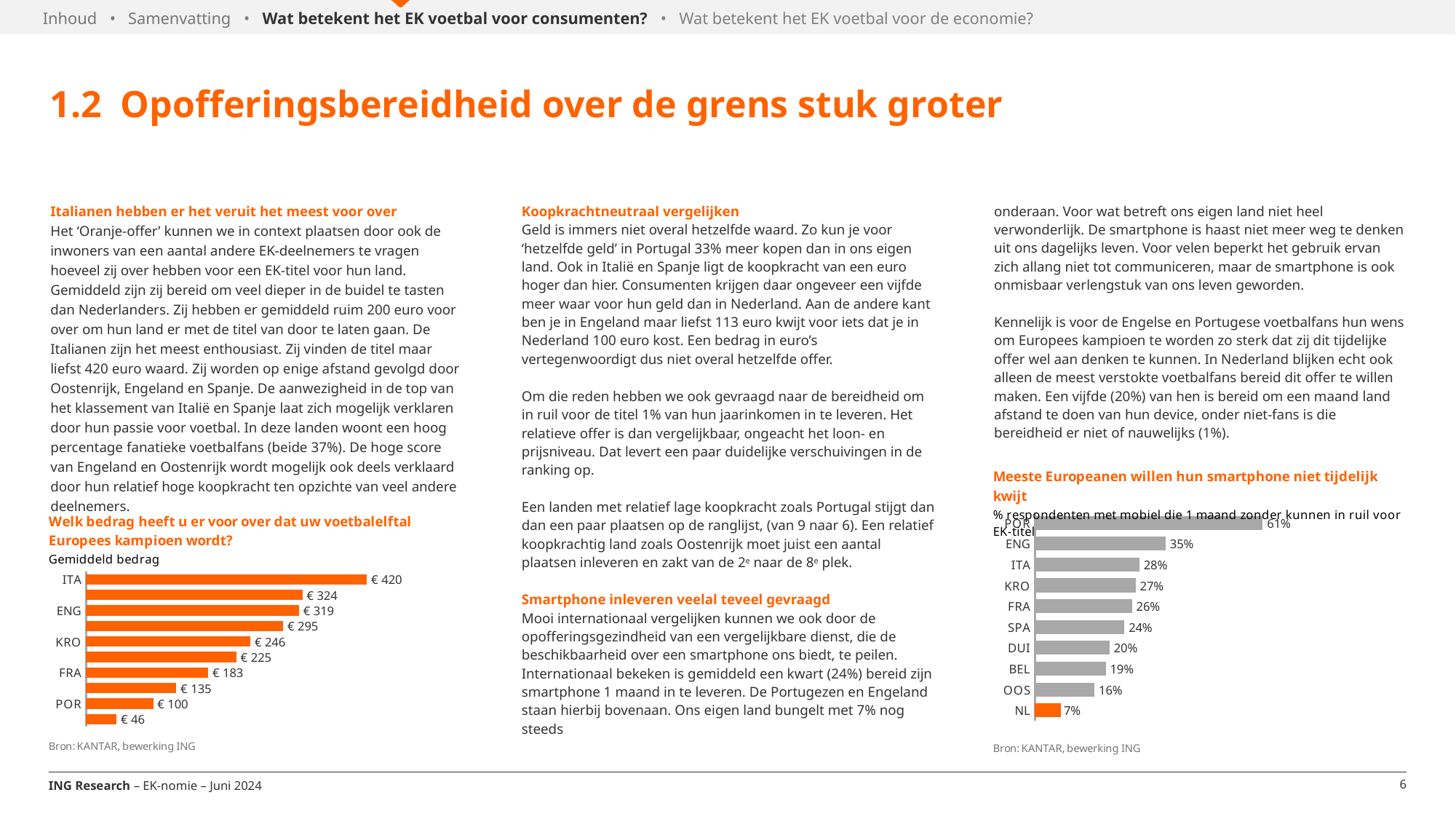
In the chart 'Welk bedrag heeft u er voor over dat uw voetbalelftal Europees kampioen wordt?', what is the value for ITA? € 420 What kind of chart is 'Welk bedrag heeft u er voor over dat uw voetbalelftal Europees kampioen wordt?'? Bar chart In the chart 'Meeste Europeanen willen hun smartphone niet tijdelijk kwijt', what is the value for POR? 61% In the chart 'Welk bedrag heeft u er voor over dat uw voetbalelftal Europees kampioen wordt?', what is the difference between the values for ENG and FRA? € 136 In the chart 'Welk bedrag heeft u er voor over dat uw voetbalelftal Europees kampioen wordt?', which labelled country has the highest value? ITA In the chart 'Meeste Europeanen willen hun smartphone niet tijdelijk kwijt', what is the value for NL? 7% In the chart 'Welk bedrag heeft u er voor over dat uw voetbalelftal Europees kampioen wordt?', what is the value for POR? € 100 In the chart 'Meeste Europeanen willen hun smartphone niet tijdelijk kwijt', which is larger, the value for DUI or the value for OOS? DUI In the chart 'Meeste Europeanen willen hun smartphone niet tijdelijk kwijt', what is the difference between the values for POR and ENG? 26% In the chart 'Meeste Europeanen willen hun smartphone niet tijdelijk kwijt', which bar is coloured orange rather than grey? NL In the chart 'Welk bedrag heeft u er voor over dat uw voetbalelftal Europees kampioen wordt?', how many bars are plotted? 10 In the chart 'Meeste Europeanen willen hun smartphone niet tijdelijk kwijt', which country has the lowest value? NL